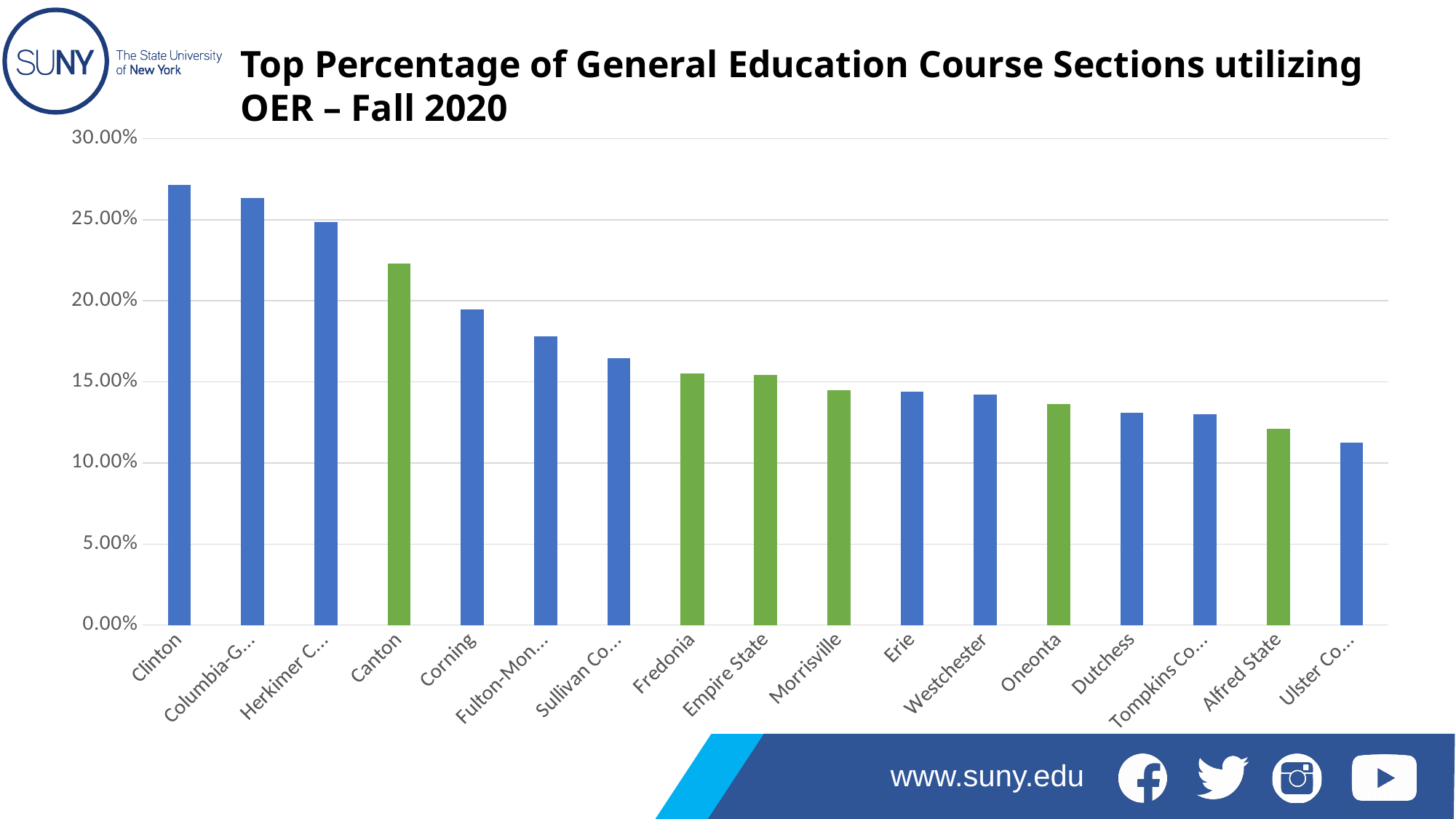
What kind of chart is shown on the slide? Bar chart Is the value for Alfred State greater or less than 10.00%? greater What is the title of the chart? Top Percentage of General Education Course Sections utilizing OER – Fall 2020 Which campus has the highest percentage of General Education course sections utilizing OER? Clinton Which is larger, the value for Canton or the value for Corning? Canton Is the value for Corning greater or less than 20.00%? less Is the value for Canton greater or less than 20.00%? greater Do the values rise or fall moving from left to right along the x axis? Fall How many campuses (bars) are shown in the chart? 17